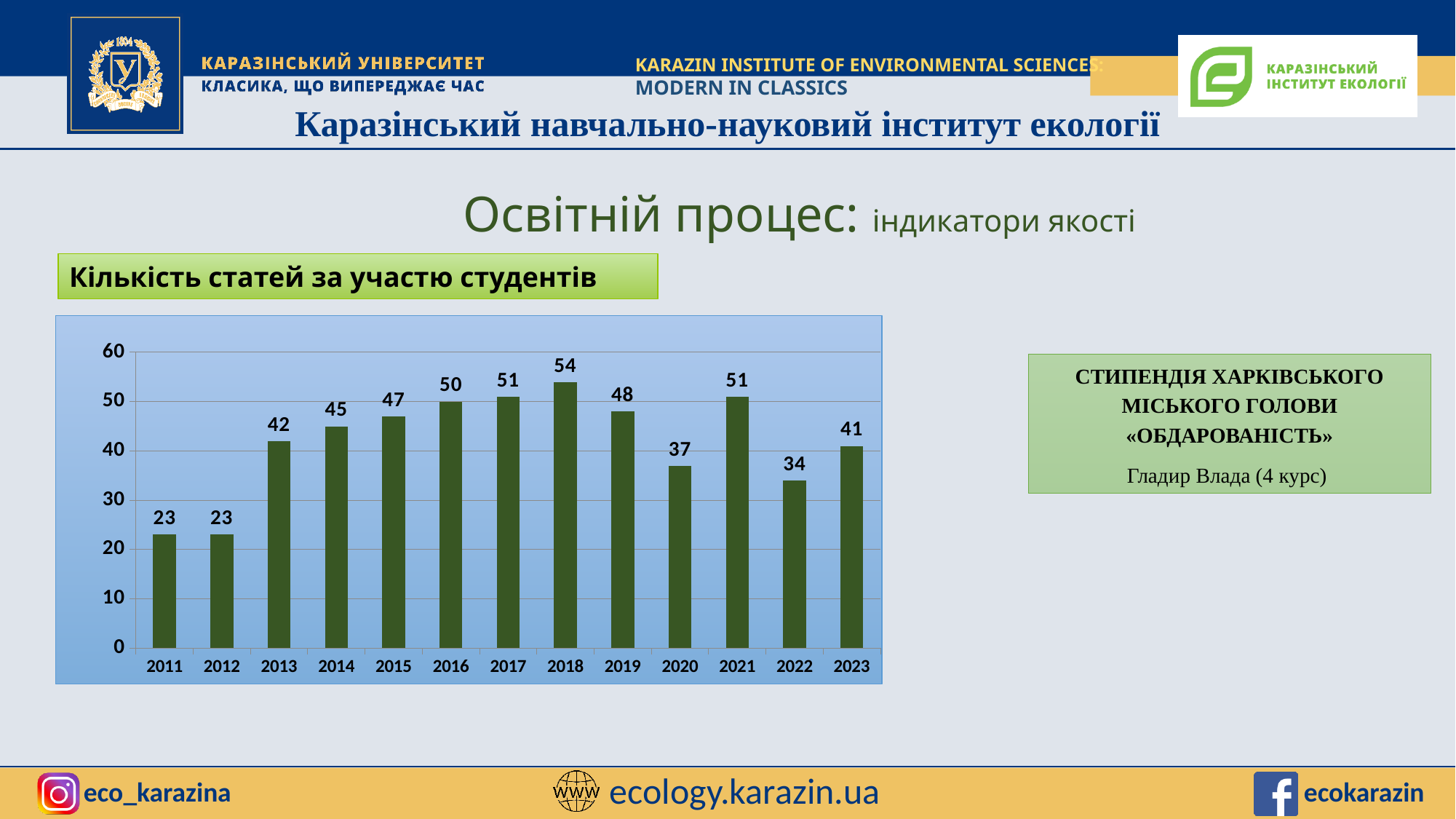
What value is shown for 2020? 37 What is the difference between the values for 2013 and 2011? 19 What is the title shown above the chart? Кількість статей за участю студентів Is the value for 2016 greater or less than 40? greater What is the difference between the values for 2018 and 2022? 20 Which year has the lowest value on the chart? 2011 and 2012 Which year has the highest value on the chart? 2018 What is the number of articles with student participation in 2018? 54 What kind of chart is shown on the slide? bar chart Do the values rise or fall from 2011 to 2018? rise Which is larger, the value for 2019 or the value for 2023? 2019 How many years are shown on the x axis? 13